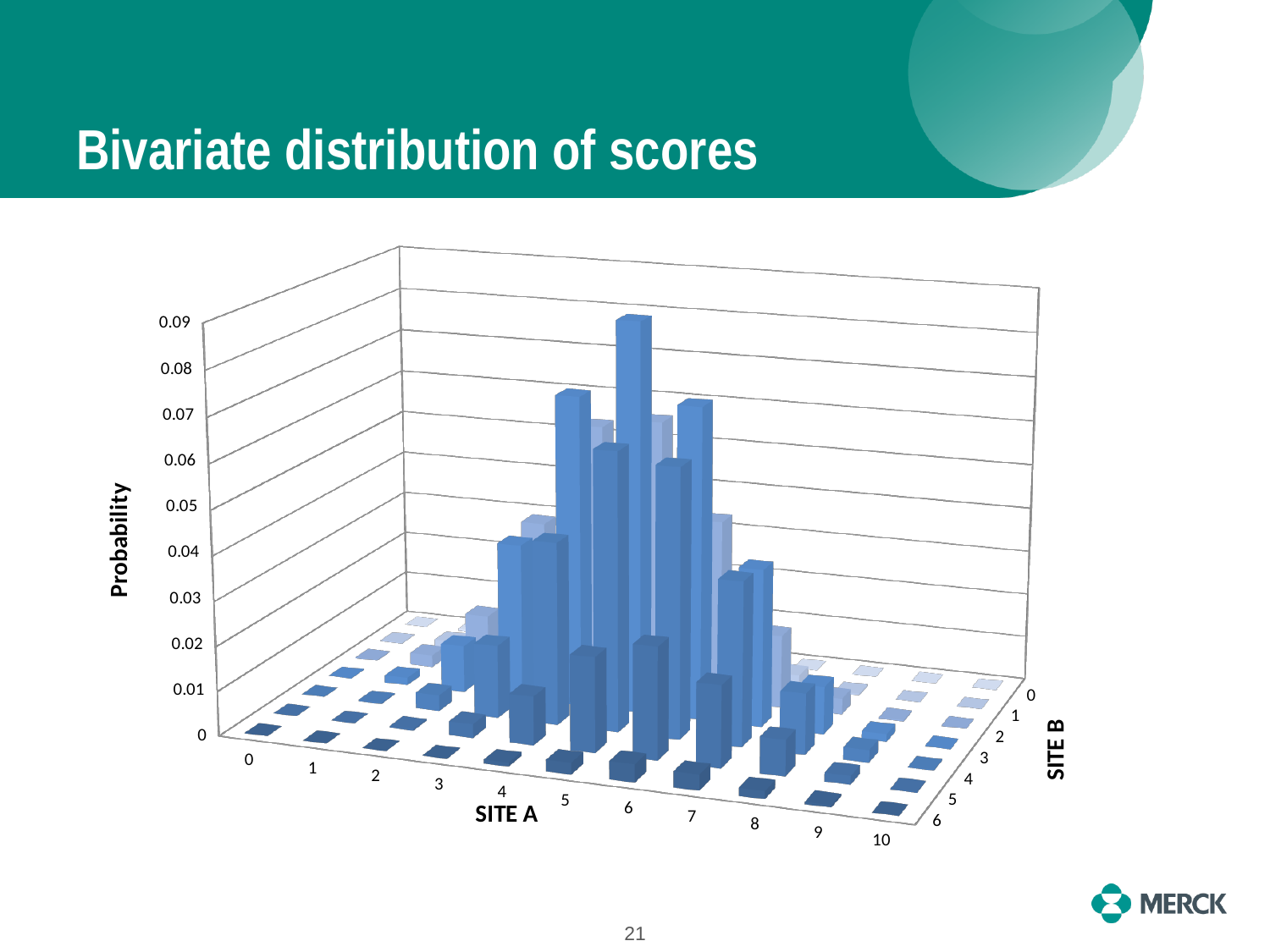
What is the highest score shown on the SITE B axis? 6 What is the lowest value shown on the Probability axis? 0 What is the highest score shown on the SITE A axis? 10 What is the label of the vertical axis of the chart? Probability Is the tallest bar in the chart greater or less than 0.04 on the Probability axis? greater What kind of chart is shown on the slide? 3D bar chart What is the highest value shown on the Probability axis? 0.09 Is the bar at SITE A = 0 and SITE B = 6 greater or less than 0.01 on the Probability axis? less What is the title of the chart on the slide? Bivariate distribution of scores How many score categories are shown along the SITE A axis? 11 How many score categories are shown along the SITE B axis? 7